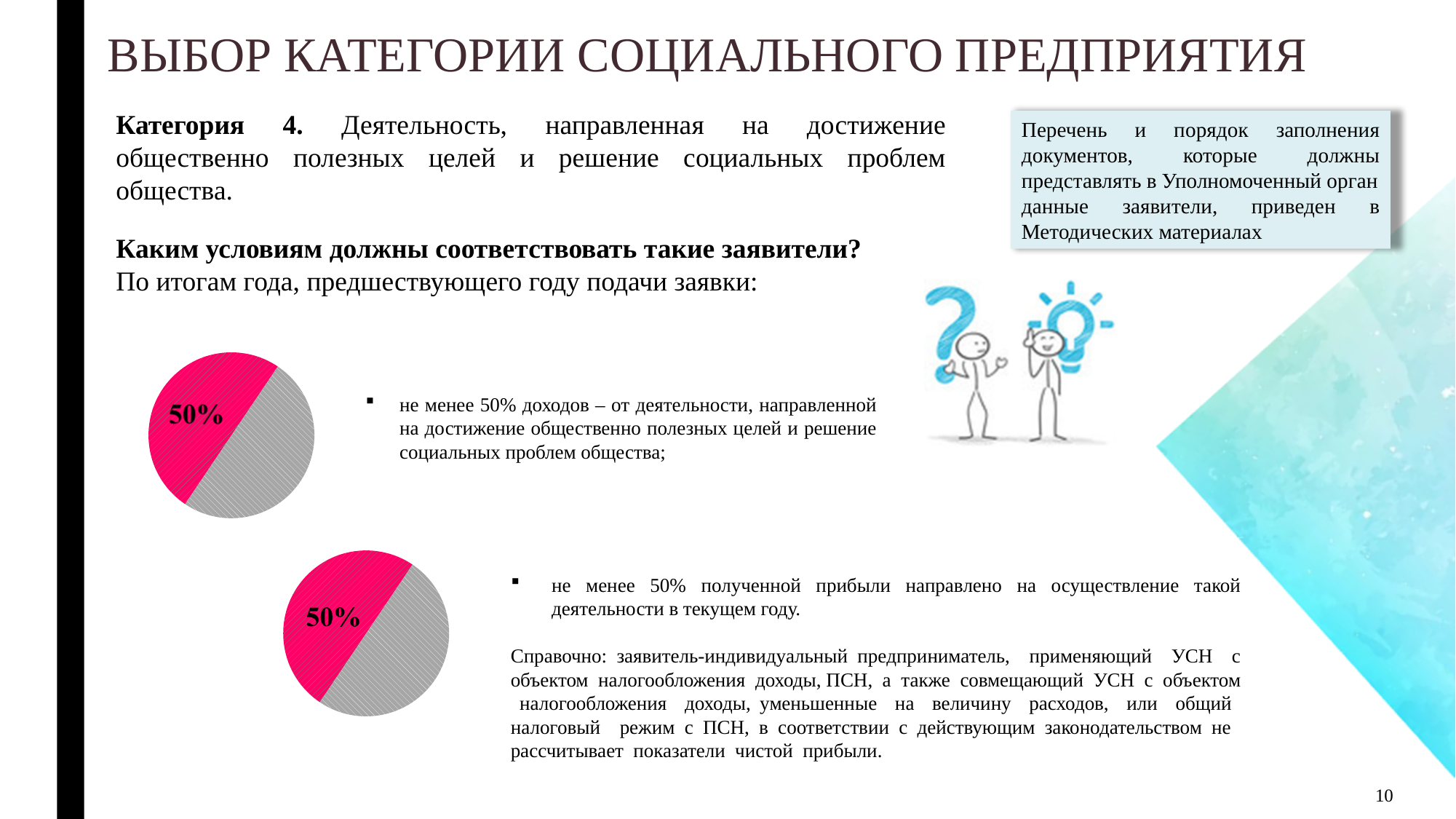
How many pie charts are shown on the slide? 2 How many slices does the upper pie chart have? 2 In the upper pie chart, what value is printed on the pink slice? 50% In the upper pie chart, what share of the pie does the pink slice represent? 50% What kind of chart is the lower chart on the left of the slide? pie chart In the lower pie chart, what share of the pie does the grey slice represent? 50% What kind of chart is the upper chart on the left of the slide? pie chart How many slices does the lower pie chart have? 2 In the lower pie chart, what value is printed on the pink slice? 50% In the upper pie chart, what colour is the slice labelled 50%? pink